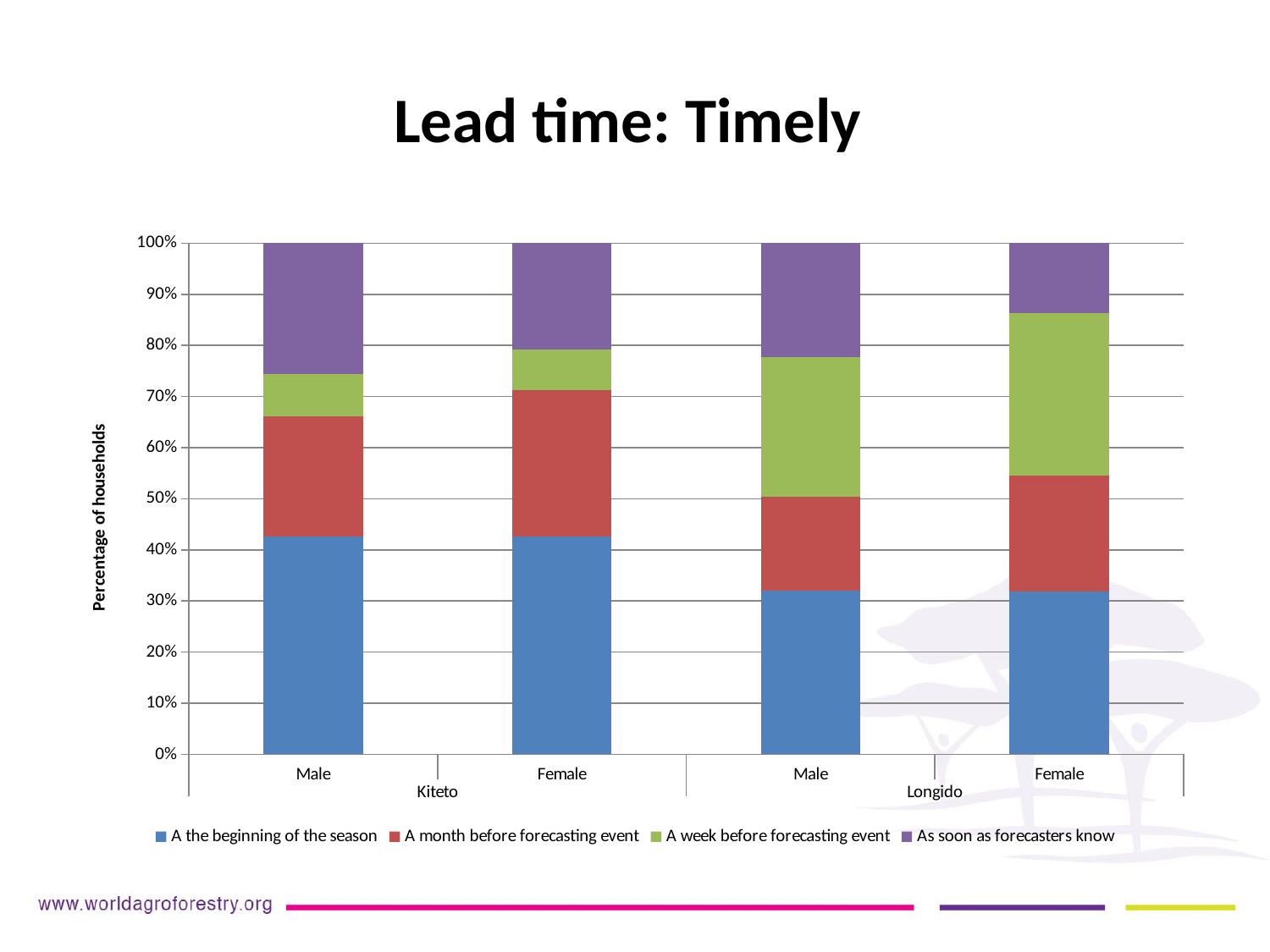
How many series does the legend list? 4 Is the value of 'A the beginning of the season' for Longido Male greater or less than 40%? less What kind of chart is shown on the slide? Stacked bar chart Which bar has the larger 'As soon as forecasters know' segment, Kiteto Male or Longido Female? Kiteto Male Does the top of the 'A week before forecasting event' segment for Longido Female reach greater or less than 80%? greater What is the total of the stacked bar for Kiteto Male? 100% How many bars are plotted in the chart? 4 Does the top of the 'A week before forecasting event' segment for Kiteto Male reach greater or less than 80%? less Which bar has the larger 'A week before forecasting event' segment, Kiteto Male or Longido Female? Longido Female What is the label on the vertical axis? Percentage of households What is the title of the chart on the slide? Lead time: Timely